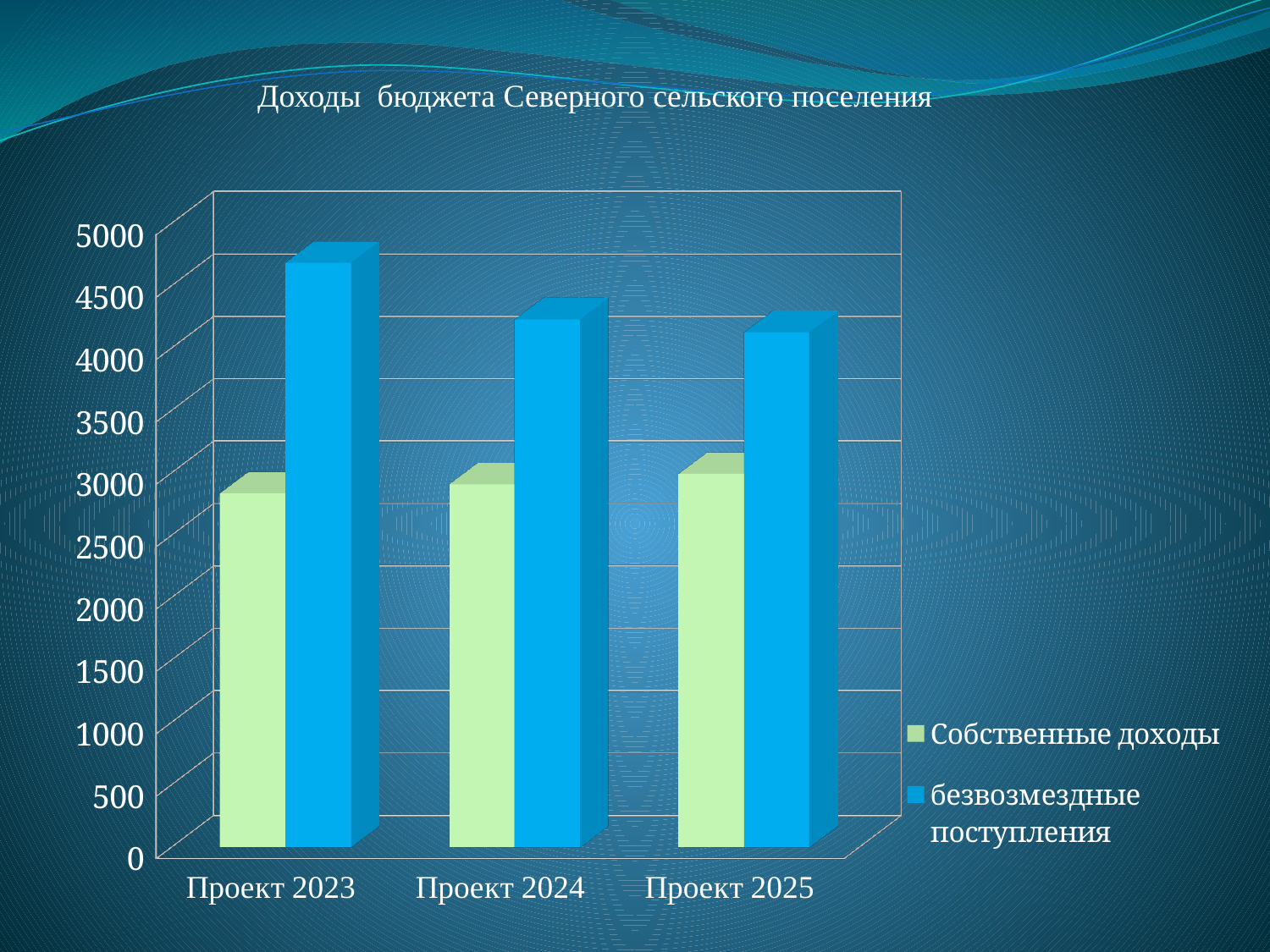
Which bar is the highest in the chart? безвозмездные поступления, Проект 2023 How many series does the legend list? 2 Which series is shown in blue? безвозмездные поступления What kind of chart is shown on the slide? bar chart Is the value of безвозмездные поступления for Проект 2024 greater or less than 4000? greater For Проект 2025, which is larger: Собственные доходы or безвозмездные поступления? безвозмездные поступления Do the values of безвозмездные поступления rise or fall from Проект 2023 to Проект 2025? fall Is the value of Собственные доходы for Проект 2023 greater or less than 2500? greater How many categories are shown on the x axis? 3 What is the title of the chart? Доходы бюджета Северного сельского поселения Is the value of безвозмездные поступления for Проект 2023 greater or less than 4500? greater For Проект 2023, which is larger: Собственные доходы or безвозмездные поступления? безвозмездные поступления